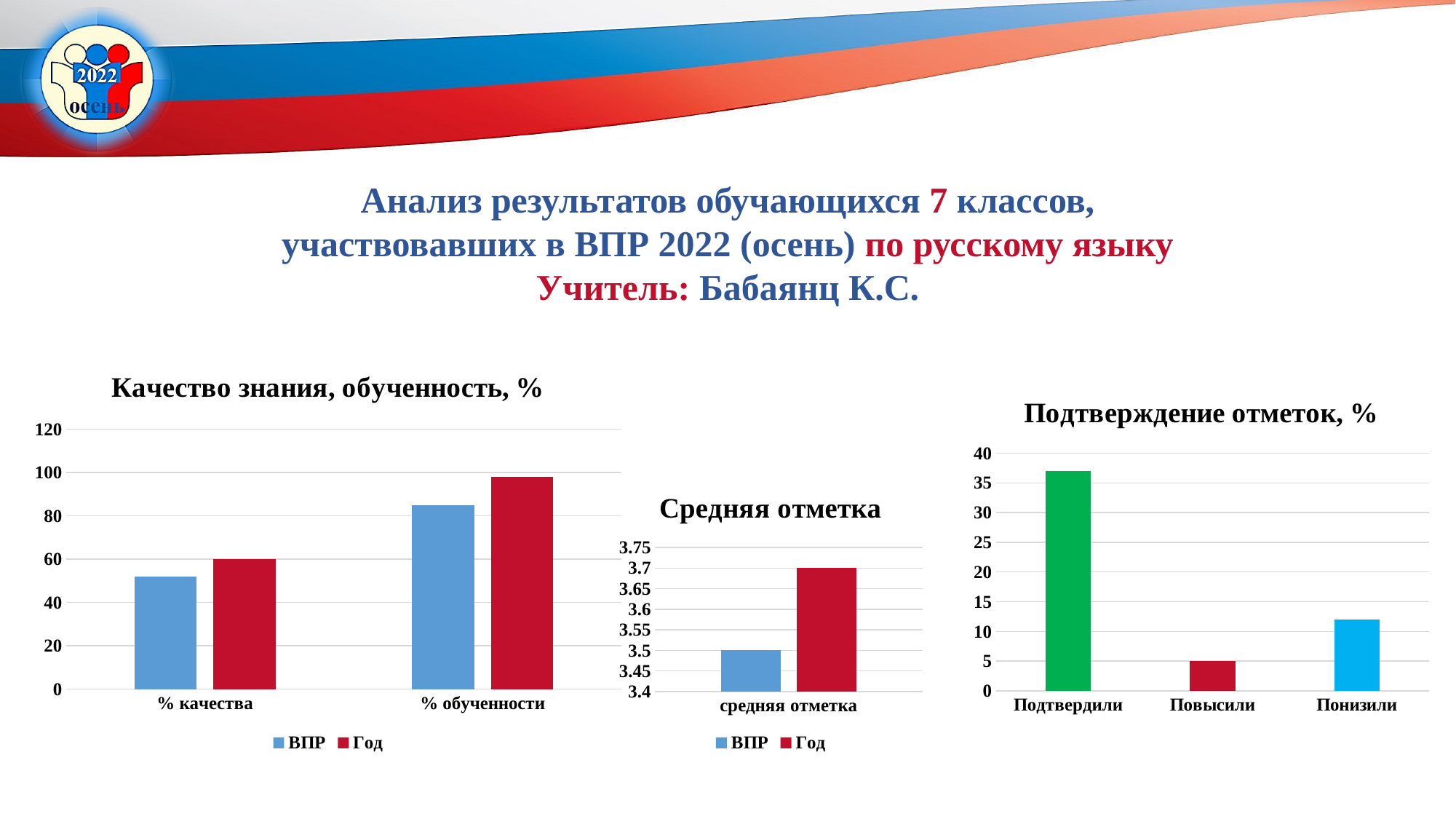
In the chart titled "Подтверждение отметок, %", what is the value for Повысили? 5 What type of chart is the chart titled "Подтверждение отметок, %"? bar chart In the chart titled "Средняя отметка", what is the value of the ВПР series? 3.5 In the chart titled "Подтверждение отметок, %", which category has the highest value? Подтвердили In the chart titled "Средняя отметка", what is the value of the Год series? 3.7 In the chart titled "Качество знания, обученность, %", which series has the larger value for % обученности, ВПР or Год? Год How many series does the legend of the chart titled "Качество знания, обученность, %" list? 2 In the chart titled "Качество знания, обученность, %", is the ВПР value for % обученности greater or less than 80? greater In the chart titled "Подтверждение отметок, %", is the value for Понизили greater or less than 10? greater In the chart titled "Средняя отметка", what is the difference between the Год value and the ВПР value? 0.2 In the chart titled "Качество знания, обученность, %", is the ВПР value for % качества greater or less than 60? less In the chart titled "Качество знания, обученность, %", what is the value of the Год series for % качества? 60